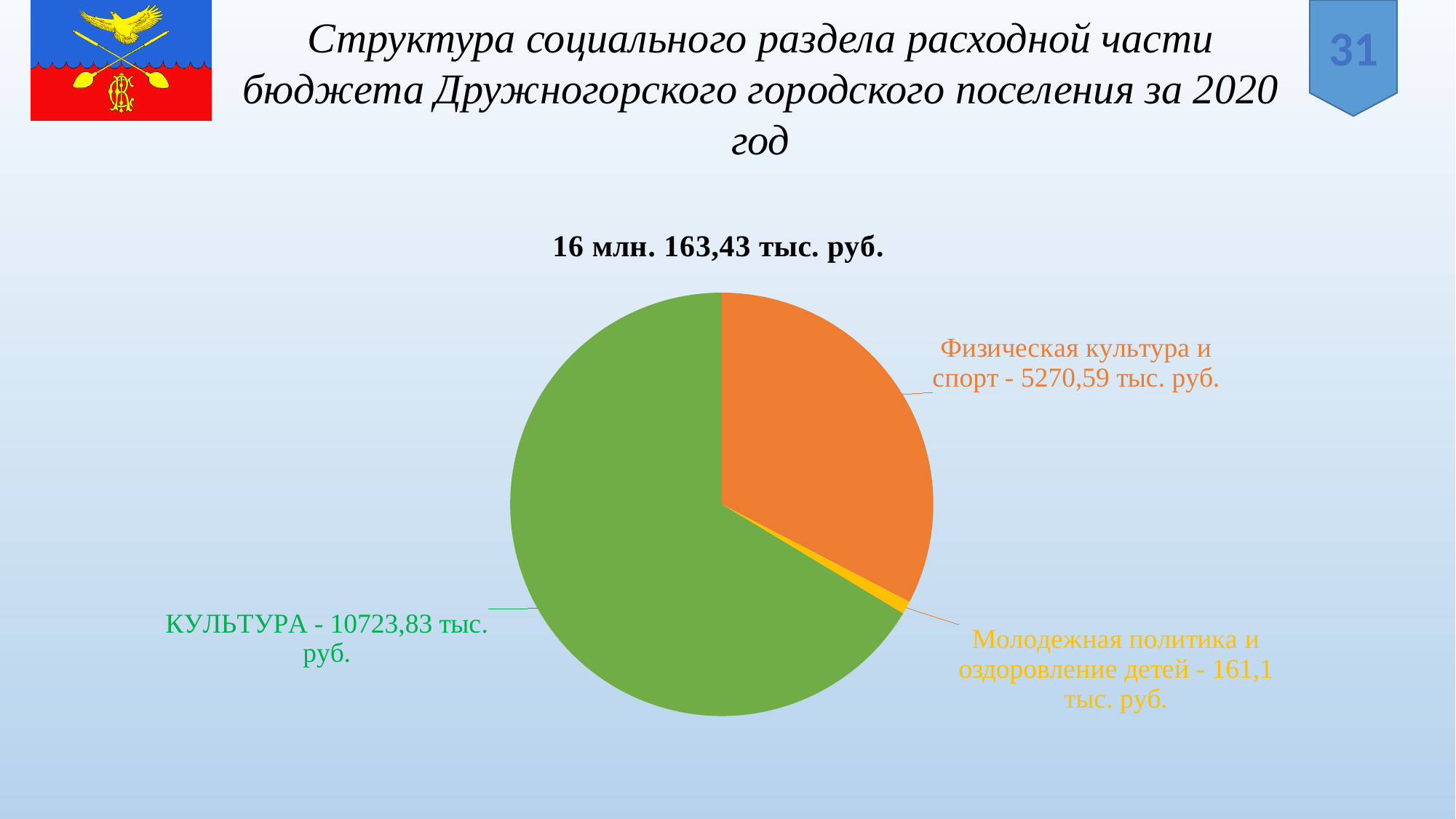
What is the difference between the value for Физическая культура и спорт and the value for Молодежная политика и оздоровление детей? 5109,49 тыс. руб. What is the value for КУЛЬТУРА in the pie chart? 10723,83 тыс. руб. What is the difference between the value for КУЛЬТУРА and the value for Физическая культура и спорт? 5453,24 тыс. руб. What is the value for Молодежная политика и оздоровление детей in the pie chart? 161,1 тыс. руб. Which is larger: the value for КУЛЬТУРА or the value for Физическая культура и спорт? КУЛЬТУРА Which category has the smallest slice of the pie chart? Молодежная политика и оздоровление детей How many slices does the pie chart have? 3 What colour is the slice for Физическая культура и спорт? orange What total amount is printed as the title above the pie chart? 16 млн. 163,43 тыс. руб. What type of chart is shown on the slide? pie chart What is the value for Физическая культура и спорт in the pie chart? 5270,59 тыс. руб. Which category has the largest slice of the pie chart? КУЛЬТУРА